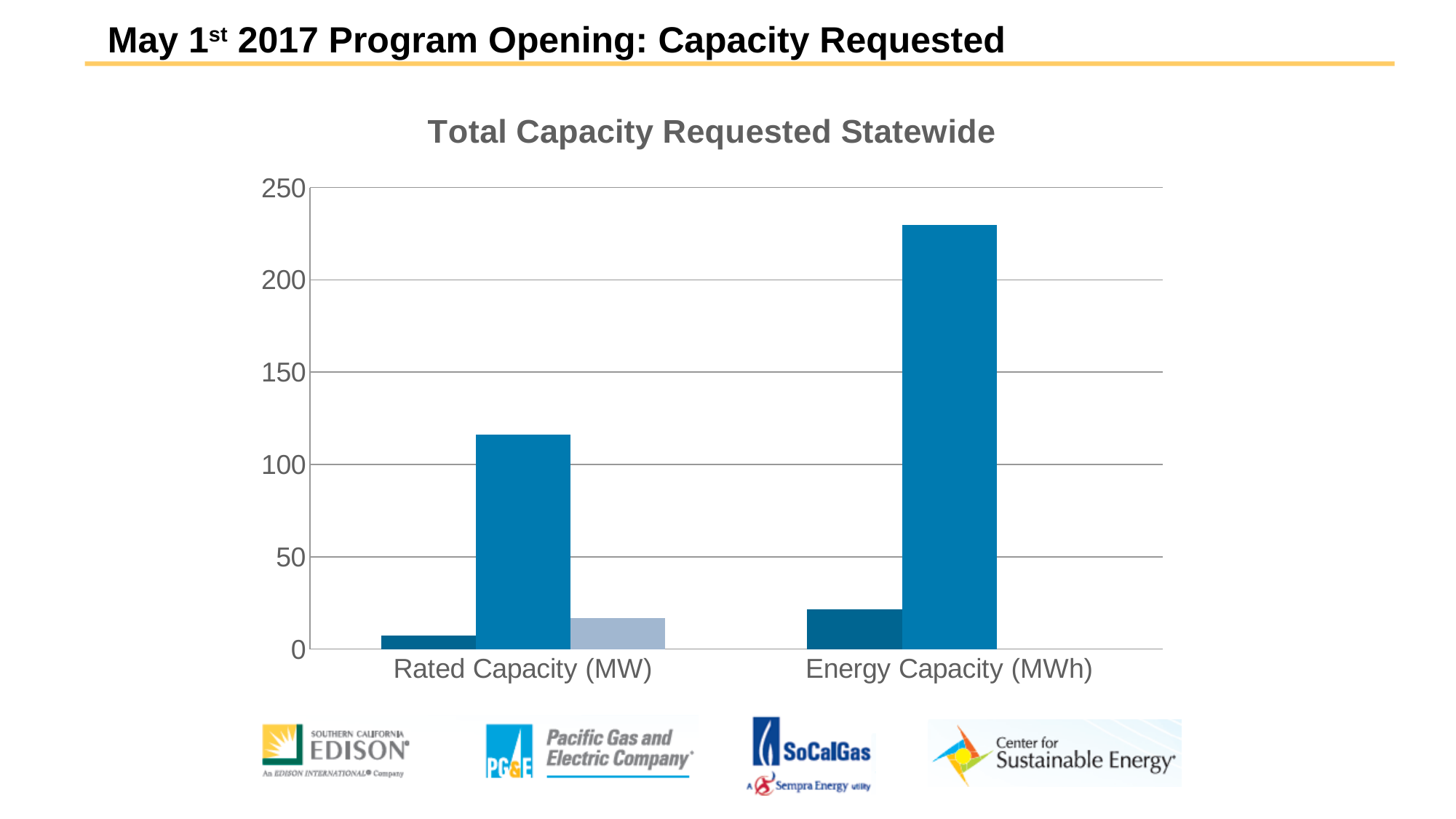
Is the dark blue (leftmost) bar in the Rated Capacity (MW) category greater or less than 50? less Is the tallest bar in the Rated Capacity (MW) category greater or less than 100? greater Which category has the tallest bar overall, Rated Capacity (MW) or Energy Capacity (MWh)? Energy Capacity (MWh) What is the title of the chart? Total Capacity Requested Statewide Which is larger: the medium blue bar for Rated Capacity (MW) or the medium blue bar for Energy Capacity (MWh)? Energy Capacity (MWh) Is the dark blue (leftmost) bar in the Energy Capacity (MWh) category greater or less than 50? less How many categories are shown on the x axis of the chart? 2 What is the highest value shown on the y axis of the chart? 250 What type of chart is shown on the slide? bar chart